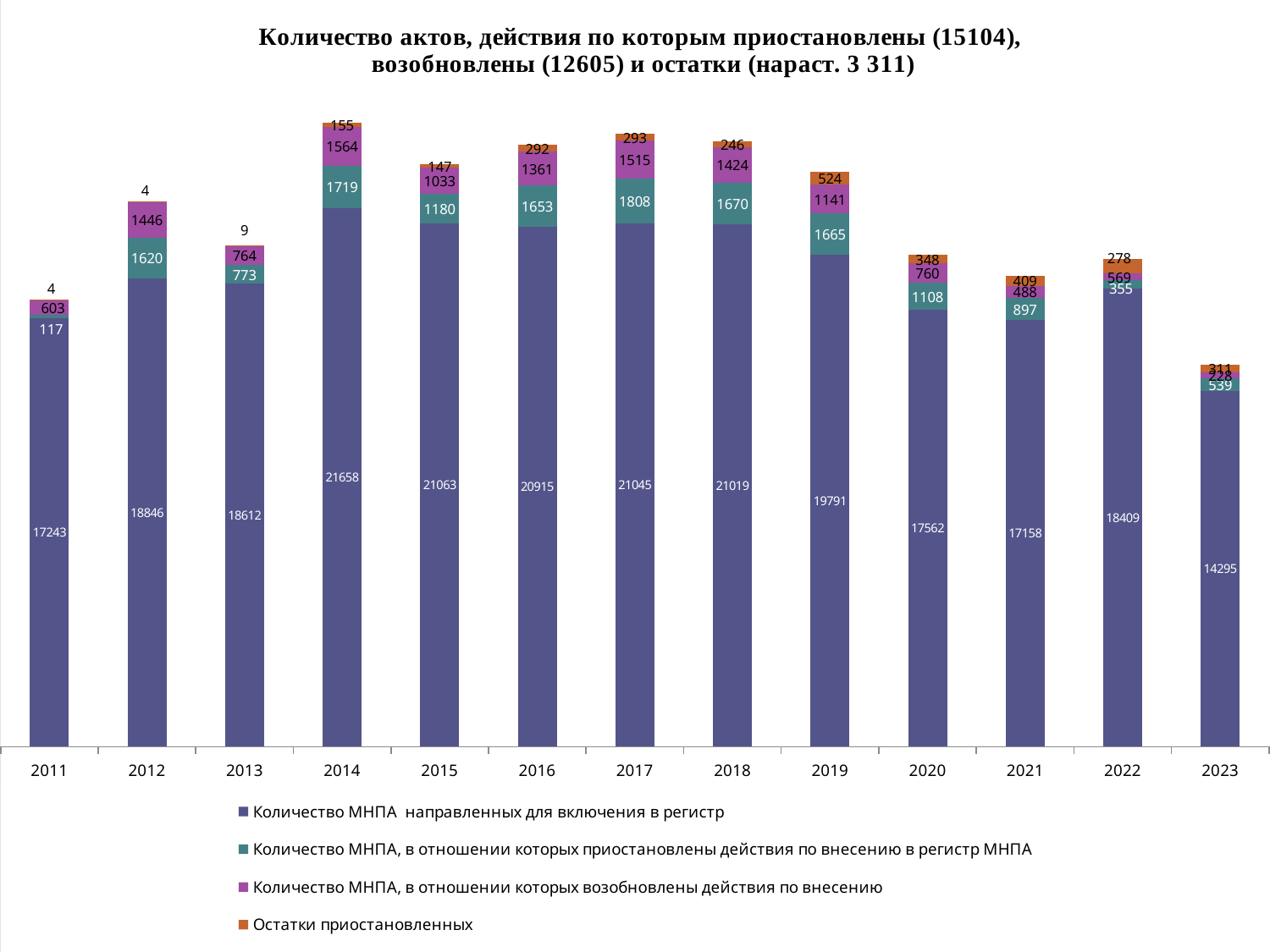
In which year is 'Количество МНПА направленных для включения в регистр' the lowest? 2023 What is the total of the stacked bar for 2023? 15373 In which year is 'Остатки приостановленных' the highest? 2019 How many series does the legend list? 4 In which year is 'Количество МНПА направленных для включения в регистр' the highest? 2014 What is the value of 'Количество МНПА направленных для включения в регистр' for 2014? 21658 What kind of chart is shown on the slide? Stacked bar chart What is the value of 'Остатки приостановленных' for 2019? 524 How many years are shown along the x axis? 13 What is the value of 'Количество МНПА, в отношении которых приостановлены действия по внесению в регистр МНПА' for 2017? 1808 What is the difference between the 'Количество МНПА направленных для включения в регистр' values for 2014 and 2023? 7363 Which is larger: the 'Количество МНПА, в отношении которых возобновлены действия по внесению' value for 2014 or for 2020? 2014